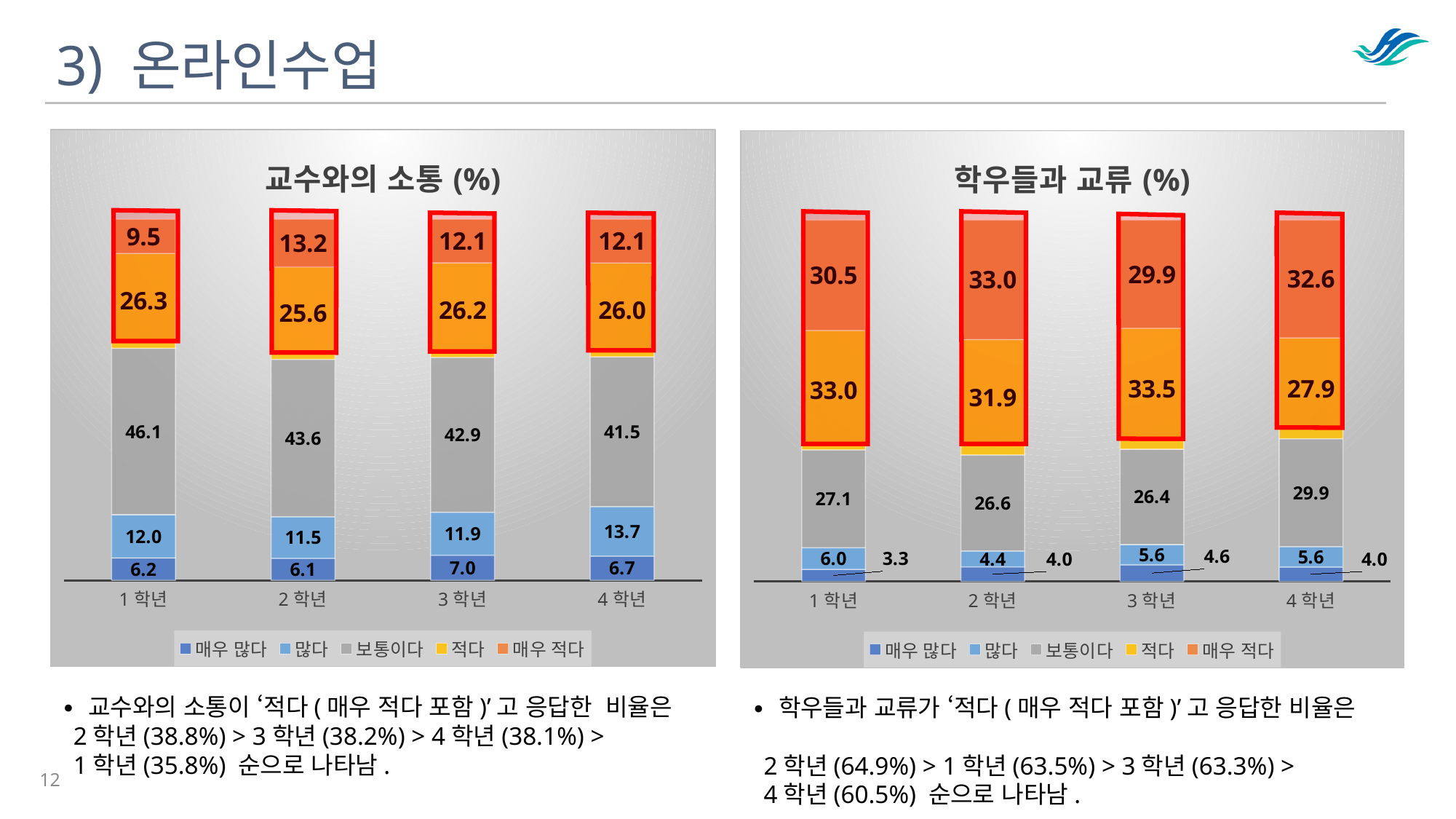
In the 학우들과 교류 (%) chart, what is the value of 적다 for 3 학년? 33.5 In the 교수와의 소통 (%) chart, what is the difference between the 많다 values for 4 학년 and 1 학년? 1.7 In the 교수와의 소통 (%) chart, does the 보통이다 value rise or fall from 1 학년 to 4 학년? Fall In the 학우들과 교류 (%) chart, which grade has the lowest value for 적다? 4 학년 In the 교수와의 소통 (%) chart, what is the value of 보통이다 for 1 학년? 46.1 In the 교수와의 소통 (%) chart, what is the value of 매우 적다 for 2 학년? 13.2 In the 학우들과 교류 (%) chart, what is the value of 매우 많다 for 1 학년? 3.3 How many series does the legend of the 학우들과 교류 (%) chart list? 5 What kind of chart is the 교수와의 소통 (%) chart? Stacked bar chart In the 학우들과 교류 (%) chart, which grade has the larger 매우 적다 value, 1 학년 or 2 학년? 2 학년 How many grade categories are shown on the x axis of the 교수와의 소통 (%) chart? 4 In the 교수와의 소통 (%) chart, which grade has the highest value for 보통이다? 1 학년